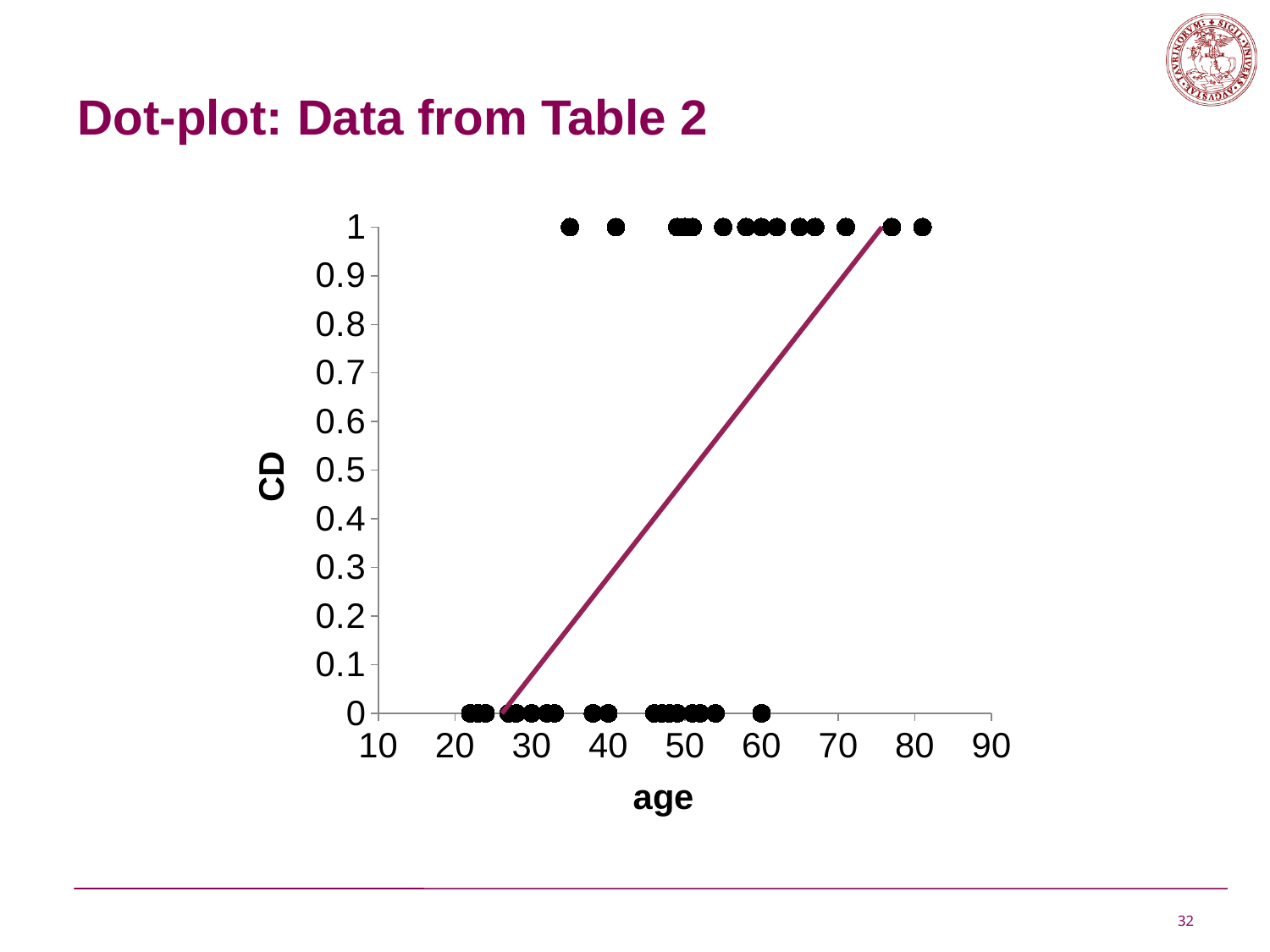
What is the CD value of the leftmost point on the chart? 0 Does the fitted line rise or fall as age increases? rises Is the age of the rightmost point with CD = 0 greater or less than 70? less What kind of chart is shown on the slide? scatter plot (dot plot) Is the age of the leftmost point with CD = 1 greater or less than 30? greater Is the age of the leftmost point on the chart greater or less than 20? greater What is the label of the x axis? age What is the highest value shown on the CD axis? 1 What is the CD value of the rightmost point on the chart? 1 Which has the larger age: the rightmost point with CD = 1 or the rightmost point with CD = 0? the rightmost point with CD = 1 What is the title of the chart on the slide? Dot-plot: Data from Table 2